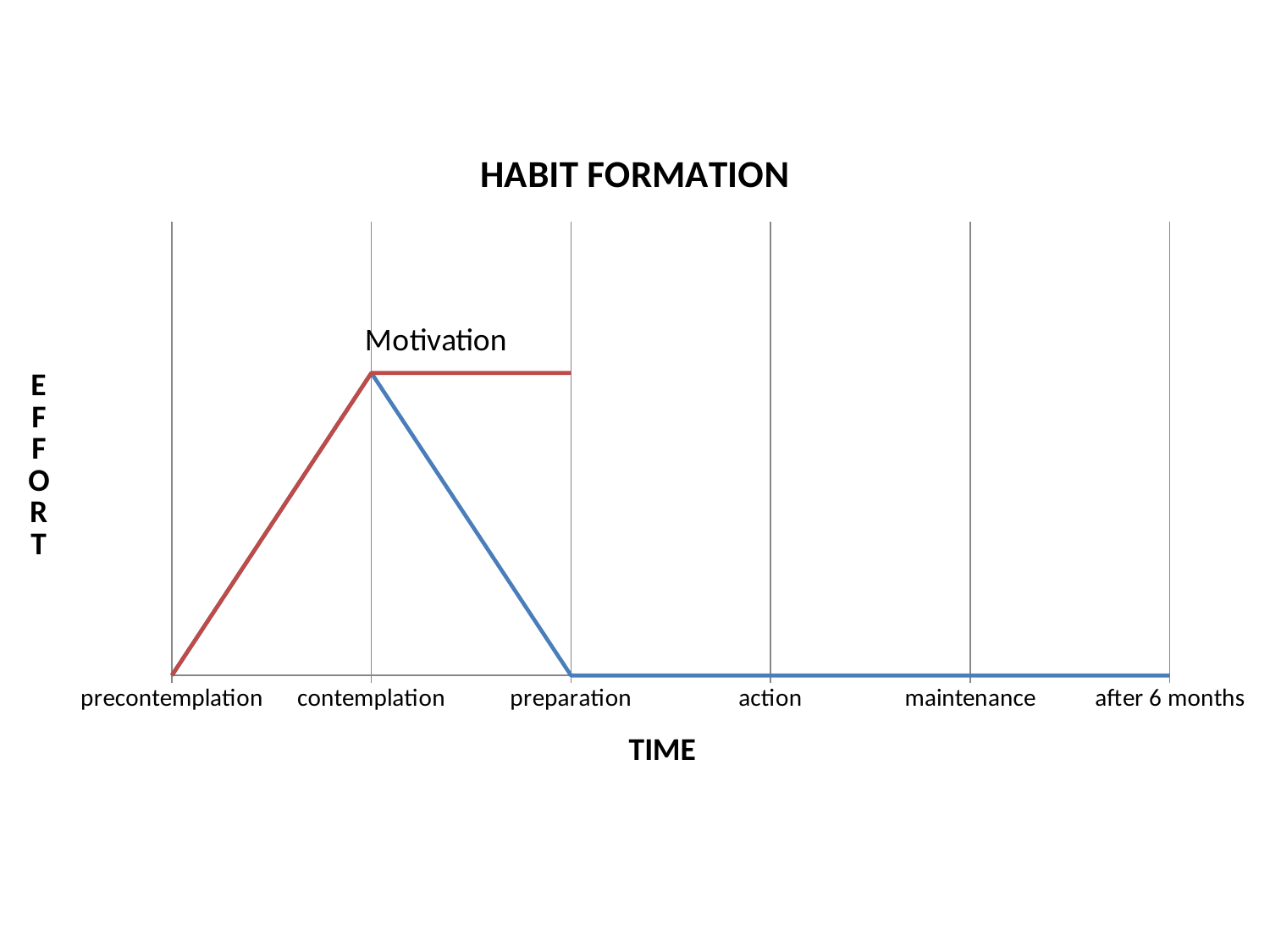
What kind of chart is shown on the slide? line chart How many lines are plotted on the chart? 2 Does the blue line rise or fall between contemplation and preparation? fall Which line on the chart is labelled "Motivation"? the red line Does the red Motivation line rise, fall or stay flat between contemplation and preparation? stay flat Which is the first category on the x axis of the chart? precontemplation At which category does the blue line reach its highest point? contemplation How many categories are shown along the x axis of the chart? 6 What is the title of the chart? HABIT FORMATION Does the red Motivation line rise or fall between precontemplation and contemplation? rise Is the blue line higher at contemplation or at preparation? contemplation